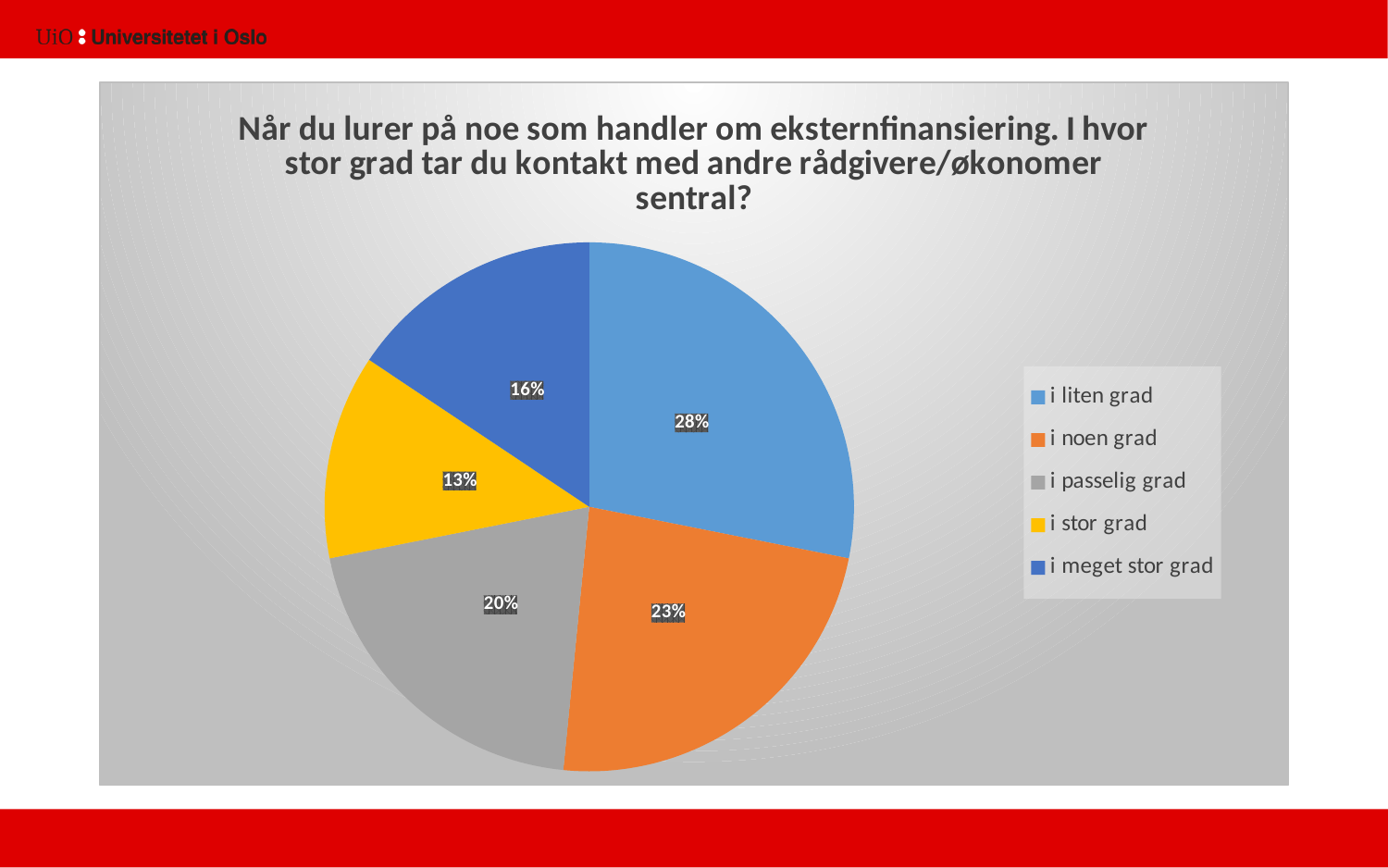
How many categories does the pie chart have? 5 What colour is the slice for "i stor grad"? yellow Which category has the smallest slice of the pie? i stor grad What is the difference in percentage points between "i liten grad" and "i stor grad"? 15 What share of the pie is labelled "i liten grad"? 28% Which is larger, the slice for "i noen grad" or the slice for "i meget stor grad"? i noen grad What share of the pie is labelled "i meget stor grad"? 16% Which category has the largest slice of the pie? i liten grad What share of the pie is labelled "i stor grad"? 13% What kind of chart is shown on the slide? pie chart